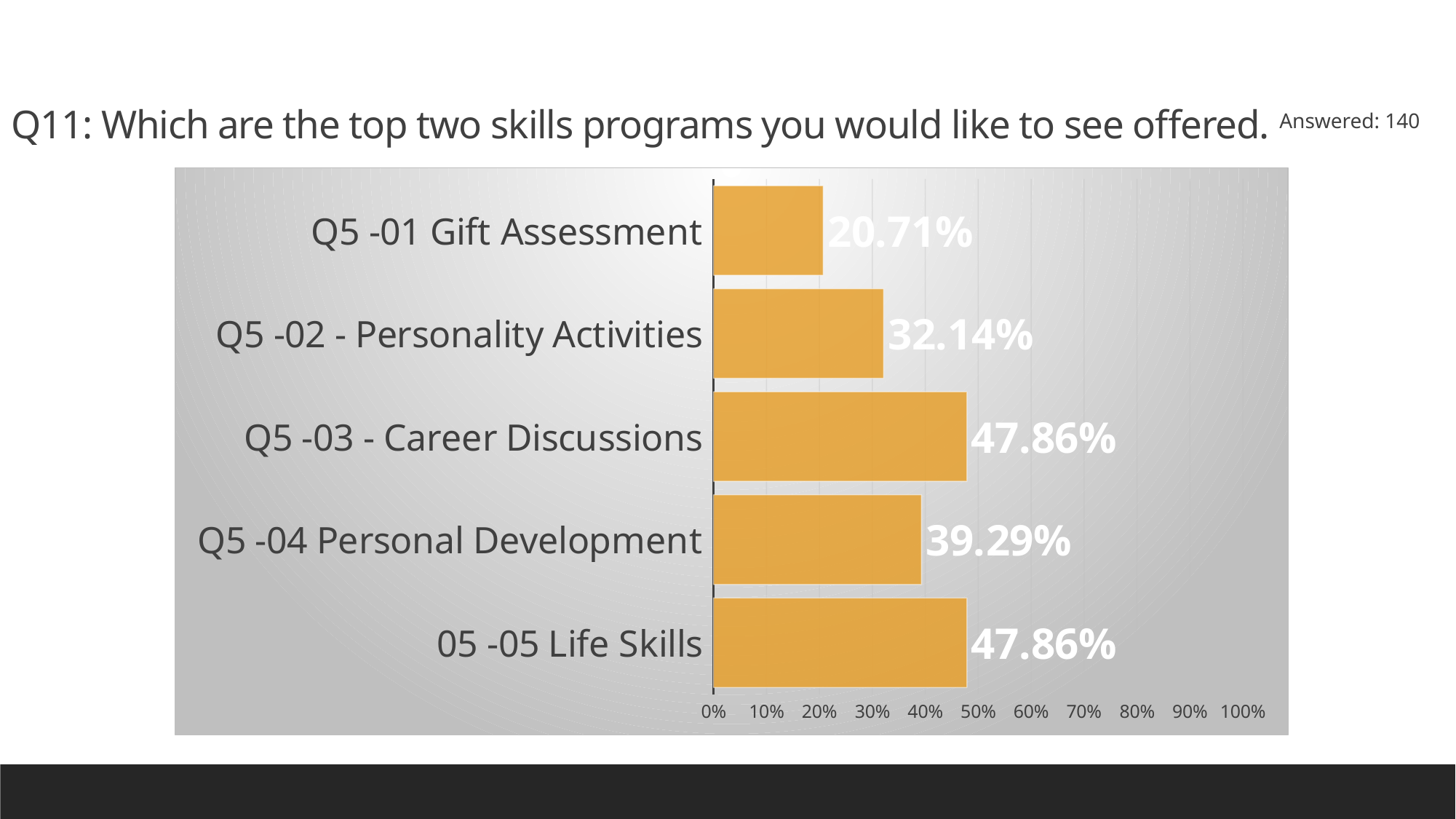
Is the value for Q5 -01 Gift Assessment greater or less than 30%? less What is the value for Q5 -01 Gift Assessment? 20.71% What is the value for Q5 -02 - Personality Activities? 32.14% How many respondents answered the question shown on the slide? 140 What kind of chart is shown on the slide? bar chart Which is larger, the value for Q5 -04 Personal Development or the value for Q5 -02 - Personality Activities? Q5 -04 Personal Development How many categories are shown in the chart? 5 What is the difference between the values for Q5 -03 - Career Discussions and Q5 -04 Personal Development? 8.57% What is the value for Q5 -04 Personal Development? 39.29% What is the difference between the values for Q5 -02 - Personality Activities and Q5 -01 Gift Assessment? 11.43% What is the value for 05 -05 Life Skills? 47.86% Which category has the lowest value? Q5 -01 Gift Assessment